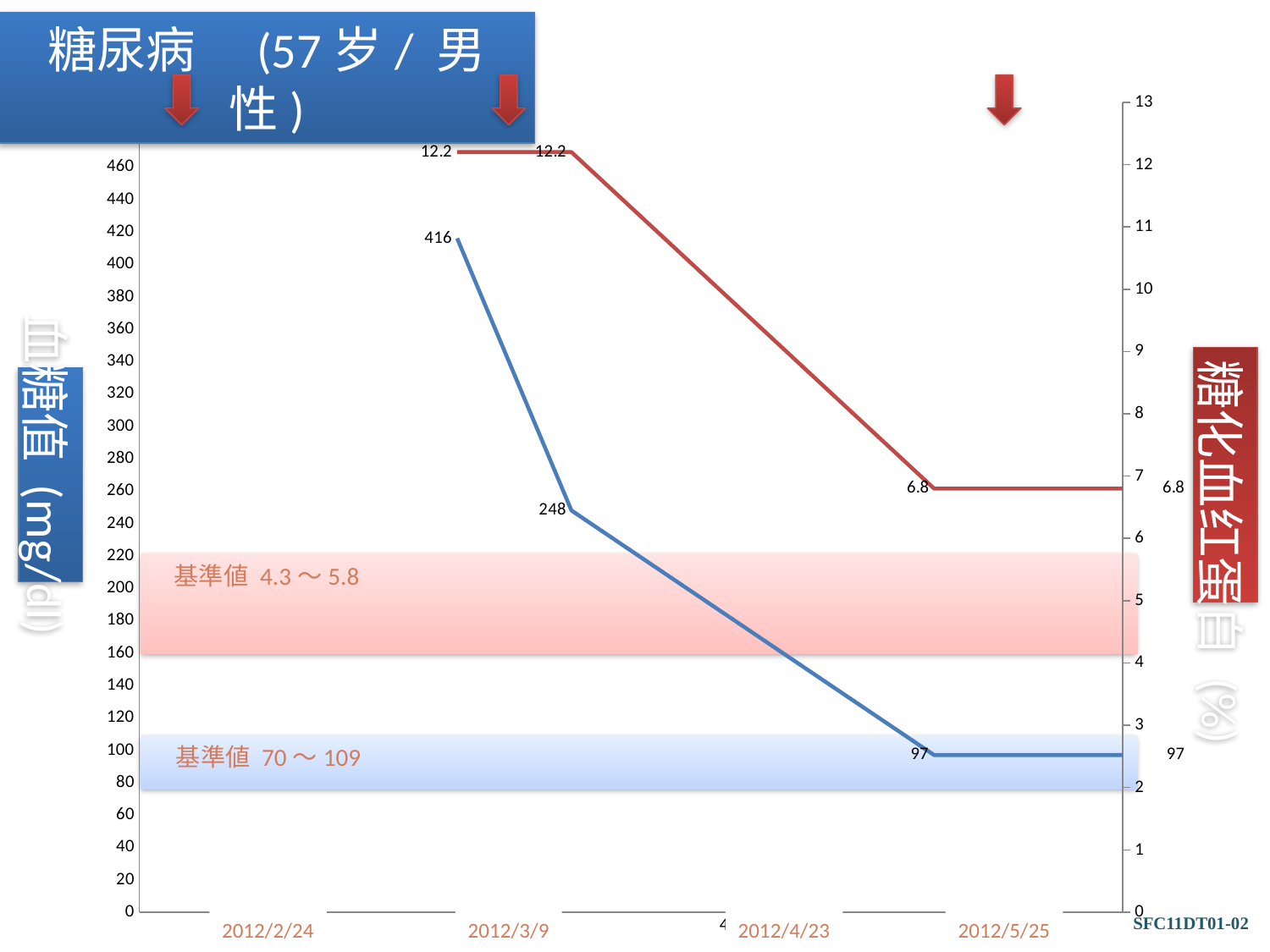
What is the highest labeled value on the blue blood glucose (血糖值) line? 416 What is the difference between the first labeled blood glucose value (416) and the last labeled value (97)? 319 Do the values on the blue blood glucose line rise or fall along the x axis? fall What reference range (基準値) is shown in the blue band for blood glucose? 70～109 What reference range (基準値) is shown in the pink band for HbA1c? 4.3～5.8 What kind of chart is shown on the slide? line chart What is the lowest labeled value on the red HbA1c (糖化血红蛋白) line? 6.8 What is the lowest labeled value on the blue blood glucose (血糖值) line? 97 What is the highest labeled value on the red HbA1c (糖化血红蛋白) line? 12.2 How many labeled data points are on the blue blood glucose line? 4 What is the difference between the first labeled HbA1c value (12.2) and the last labeled value (6.8)? 5.4 What is the difference between the first two labeled blood glucose values, 416 and 248? 168